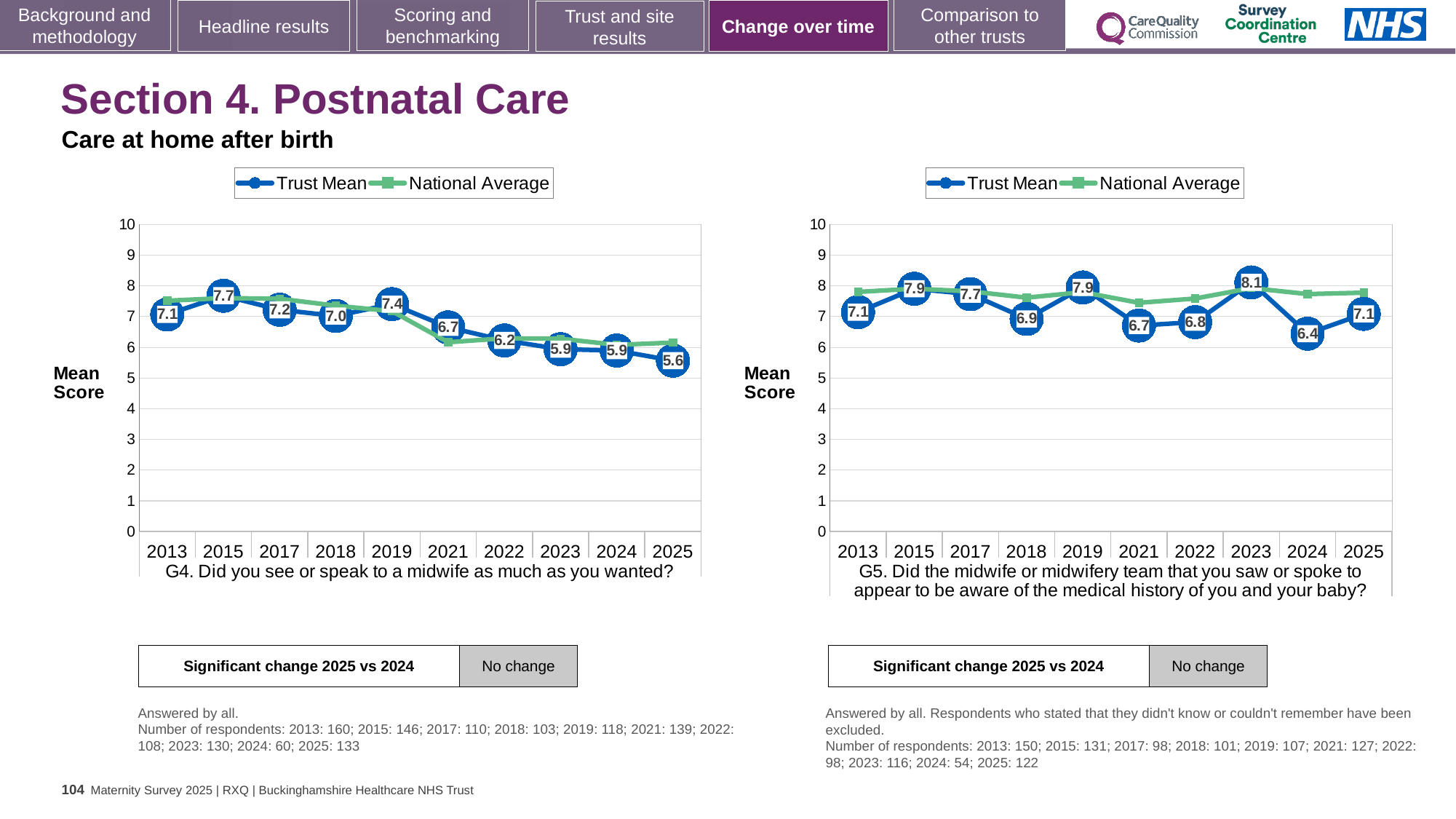
In the G4 chart (left), what is the difference between the Trust Mean scores for 2015 and 2025? 2.1 In the G4 chart (left), which year has the lowest Trust Mean score? 2025 In the G5 chart (right), which year has the lowest Trust Mean score? 2024 In the G5 chart (right), is the National Average for 2024 greater or less than 7? greater In the G5 chart (right), what is the Trust Mean score for 2023? 8.1 In the G4 chart (left), what is the Trust Mean score for 2019? 7.4 In the G4 chart (left), what is the Trust Mean score for 2025? 5.6 In the G5 chart (right), which is larger, the Trust Mean for 2018 or for 2019? 2019 How many series does the legend of the G5 chart (right) list? 2 In the G4 chart (left), is the National Average for 2013 greater or less than 7? greater In the G4 chart (left), which year has the highest Trust Mean score? 2015 How many years are plotted on the x axis of the G4 chart (left)? 10